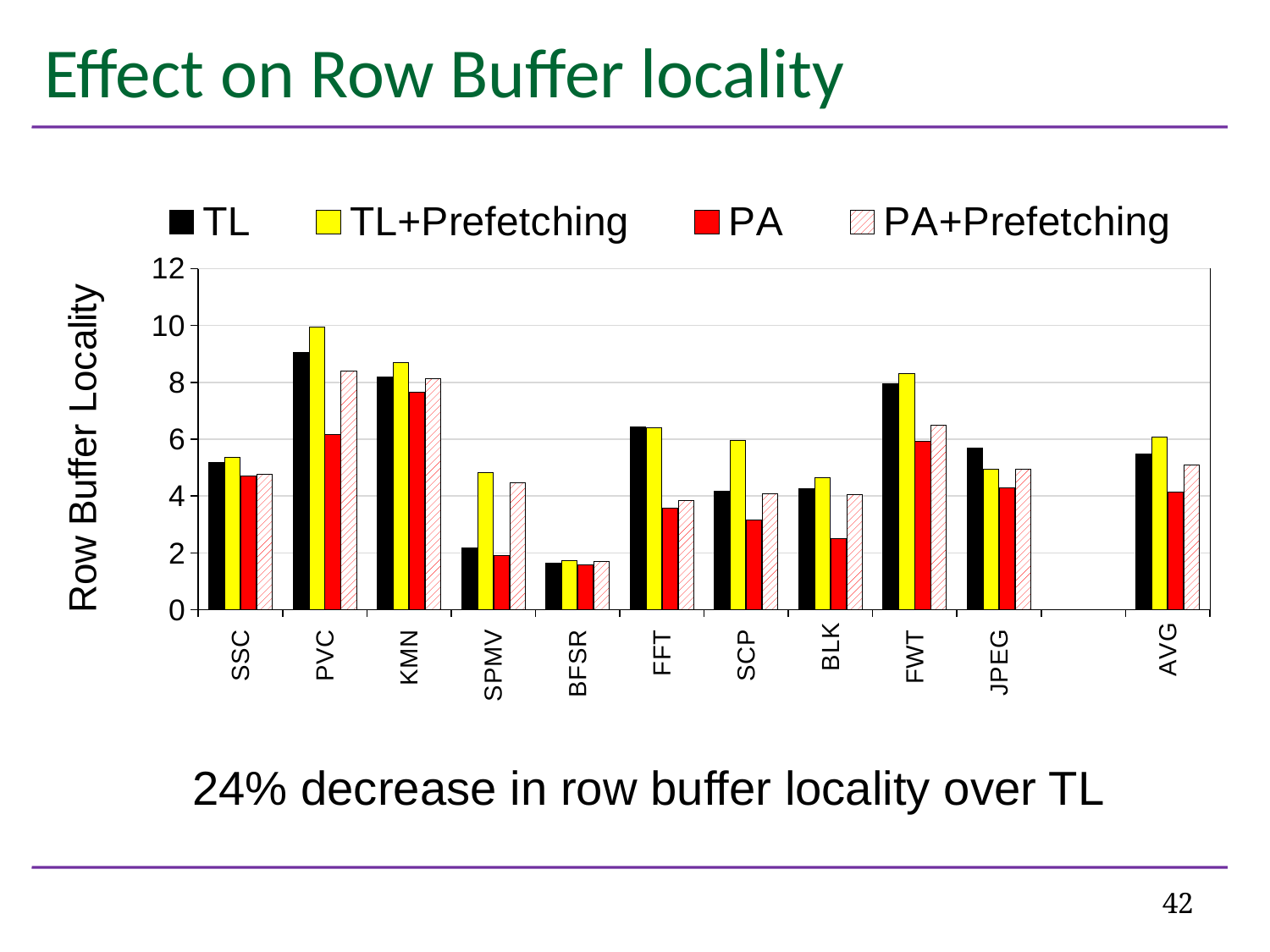
How many categories are shown on the x axis? 11 Is the PA value for AVG greater or less than 6? less Which is larger for SCP, the TL+Prefetching value or the PA value? TL+Prefetching Is the TL+Prefetching value for PVC greater or less than 8? greater Which is larger, the TL value for PVC or the TL value for KMN? PVC Which category has the lowest TL value? BFSR Which category has the highest TL+Prefetching value? PVC Which category has the highest TL value? PVC What kind of chart is shown on the slide? bar chart How many series does the legend list? 4 What is the label of the y axis? Row Buffer Locality Is the TL value for SPMV greater or less than 4? less